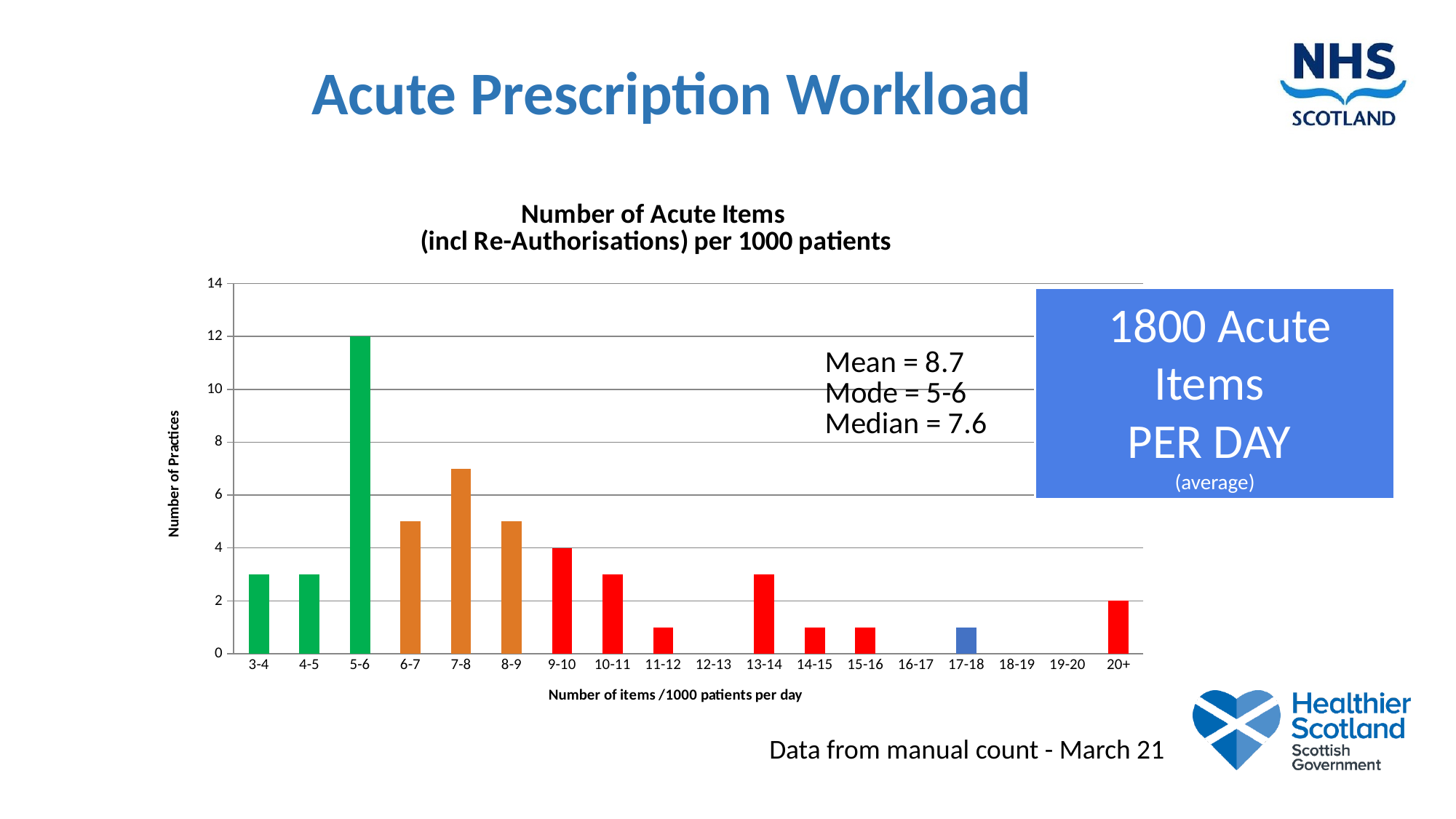
How many categories are shown on the x axis of the chart? 18 What is the number of practices for the 9-10 category? 4 Is the number of practices for the 11-12 category greater or less than 2? less What type of chart is shown on the slide? bar chart Is the number of practices for the 7-8 category greater or less than 6? greater What is the number of practices for the 5-6 category? 12 Which category has more practices, 7-8 or 6-7? 7-8 Which category has the highest number of practices? 5-6 What is the title of the chart? Number of Acute Items (incl Re-Authorisations) per 1000 patients What is the label of the y axis of the chart? Number of Practices What is the number of practices for the 20+ category? 2 What is the difference in number of practices between the 5-6 and 9-10 categories? 8